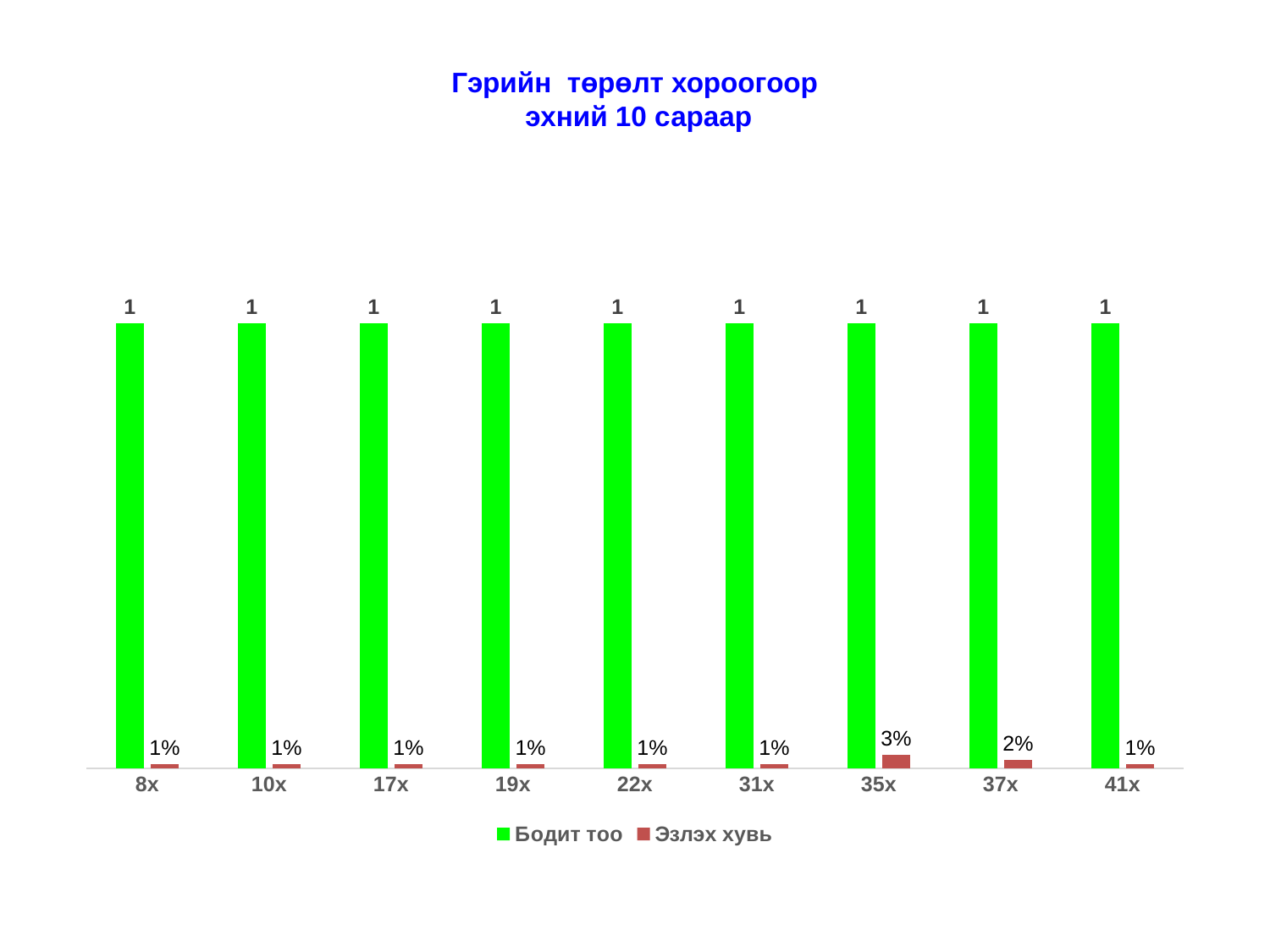
What is the value of Эзлэх хувь for 35х? 3% What is the value of Эзлэх хувь for 37х? 2% What is the difference between the Эзлэх хувь values for 35х and 37х? 1% What is the value of Бодит тоо for 22х? 1 What kind of chart is shown on the slide? bar chart How many categories are shown on the x axis? 9 How many series does the legend list? 2 What is the title of the chart? Гэрийн төрөлт хороогоор эхний 10 сараар Which category has the highest Эзлэх хувь value? 35х Which is larger, the Эзлэх хувь value for 37х or for 41х? 37х What is the value of Эзлэх хувь for 8х? 1% Which series is shown in green? Бодит тоо